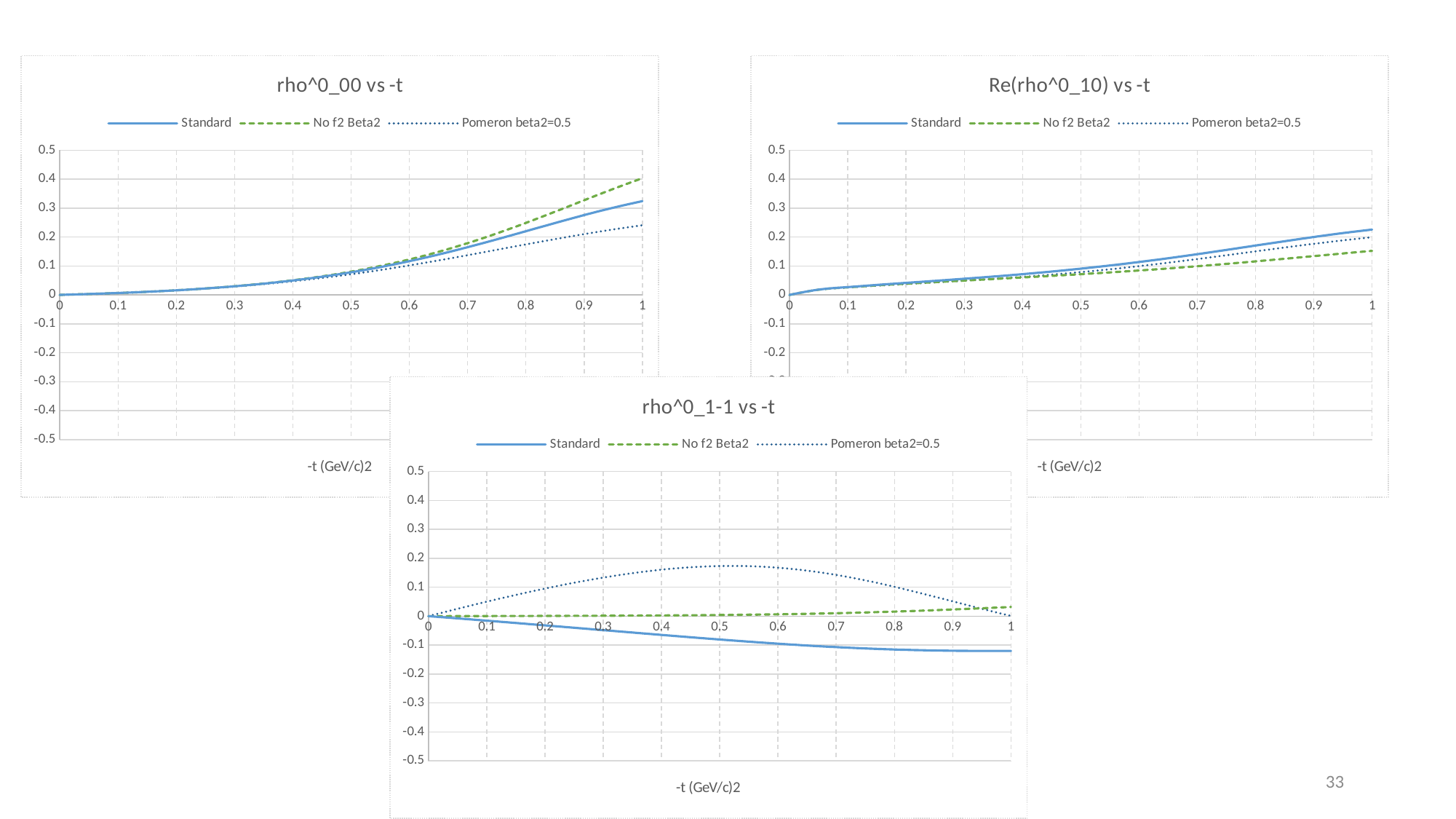
In the "rho^0_00 vs -t" chart, which series has the highest value at -t = 1? No f2 Beta2 In the "rho^0_1-1 vs -t" chart, which series reaches the highest value? Pomeron beta2=0.5 In the "rho^0_00 vs -t" chart, is the value of the Pomeron beta2=0.5 series at -t = 1 greater or less than 0.3? less How many series does the legend of the "rho^0_1-1 vs -t" chart list? 3 In the "rho^0_1-1 vs -t" chart, is the value of the Standard series at -t = 1 greater or less than 0? less In the "Re(rho^0_10) vs -t" chart, do the values of the Standard series rise or fall as -t increases? rise What kind of chart is the "rho^0_00 vs -t" chart? line chart What is the x-axis title of the "rho^0_1-1 vs -t" chart? -t (GeV/c)2 In the "Re(rho^0_10) vs -t" chart, is the value of the No f2 Beta2 series at -t = 1 greater or less than 0.2? less In the "Re(rho^0_10) vs -t" chart, which series has the lowest value at -t = 1? No f2 Beta2 In the "rho^0_1-1 vs -t" chart, which series is larger at -t = 0.5, Standard or Pomeron beta2=0.5? Pomeron beta2=0.5